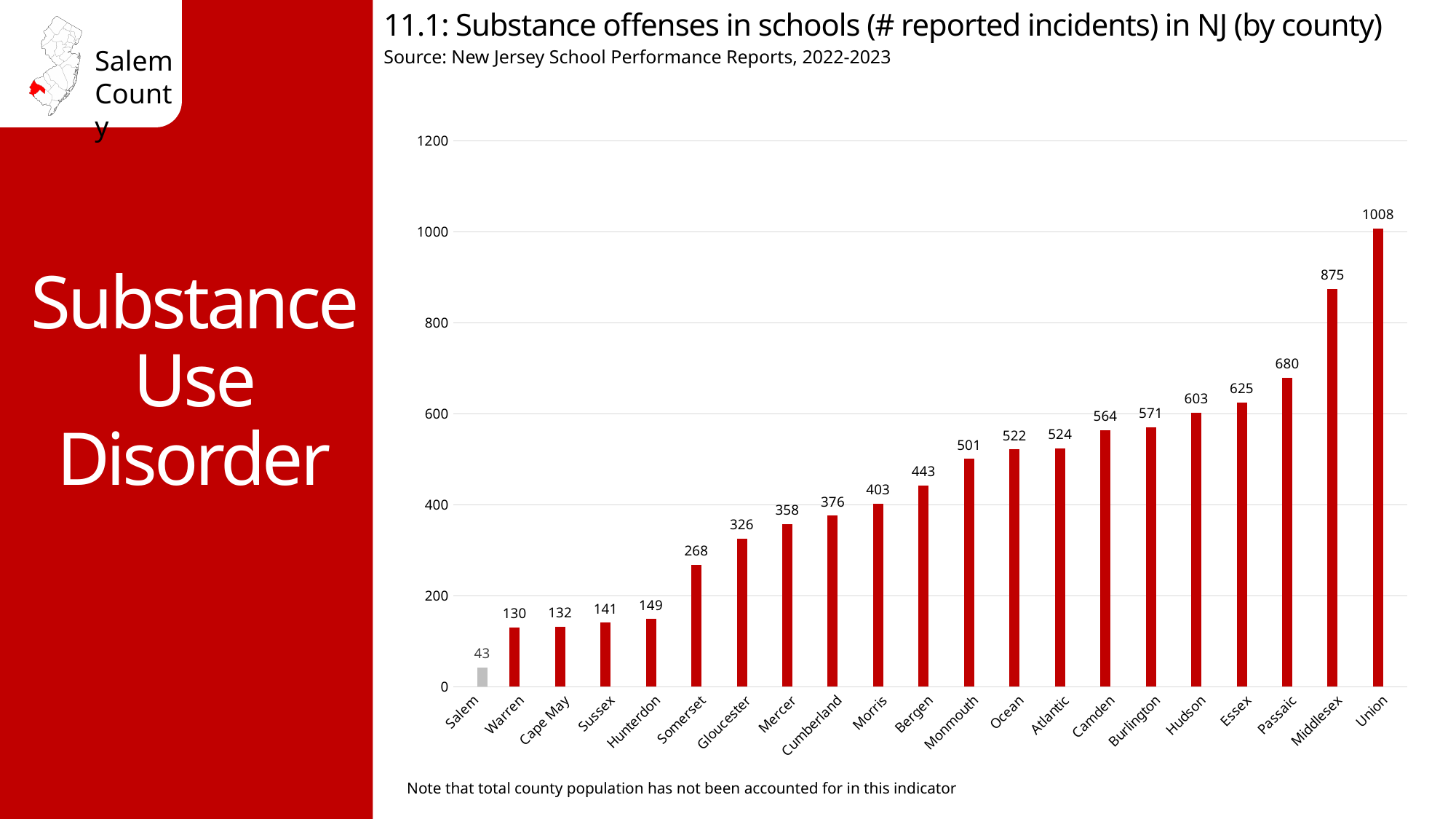
What is the value shown for Middlesex county? 875 What kind of chart is shown on the slide? Bar chart Which county has the highest number of reported incidents? Union How many counties are shown on the x axis? 21 What is the value shown for Monmouth county? 501 Do the values rise or fall moving from left to right along the x axis? Rise Which county has a larger value, Camden or Bergen? Camden What is the number of reported substance offense incidents in schools for Salem county? 43 What is the difference between the values for Union and Middlesex? 133 Which bar is coloured differently (grey) from the rest? Salem Is the value for Passaic greater or less than 600? greater Which county has the lowest number of reported incidents? Salem